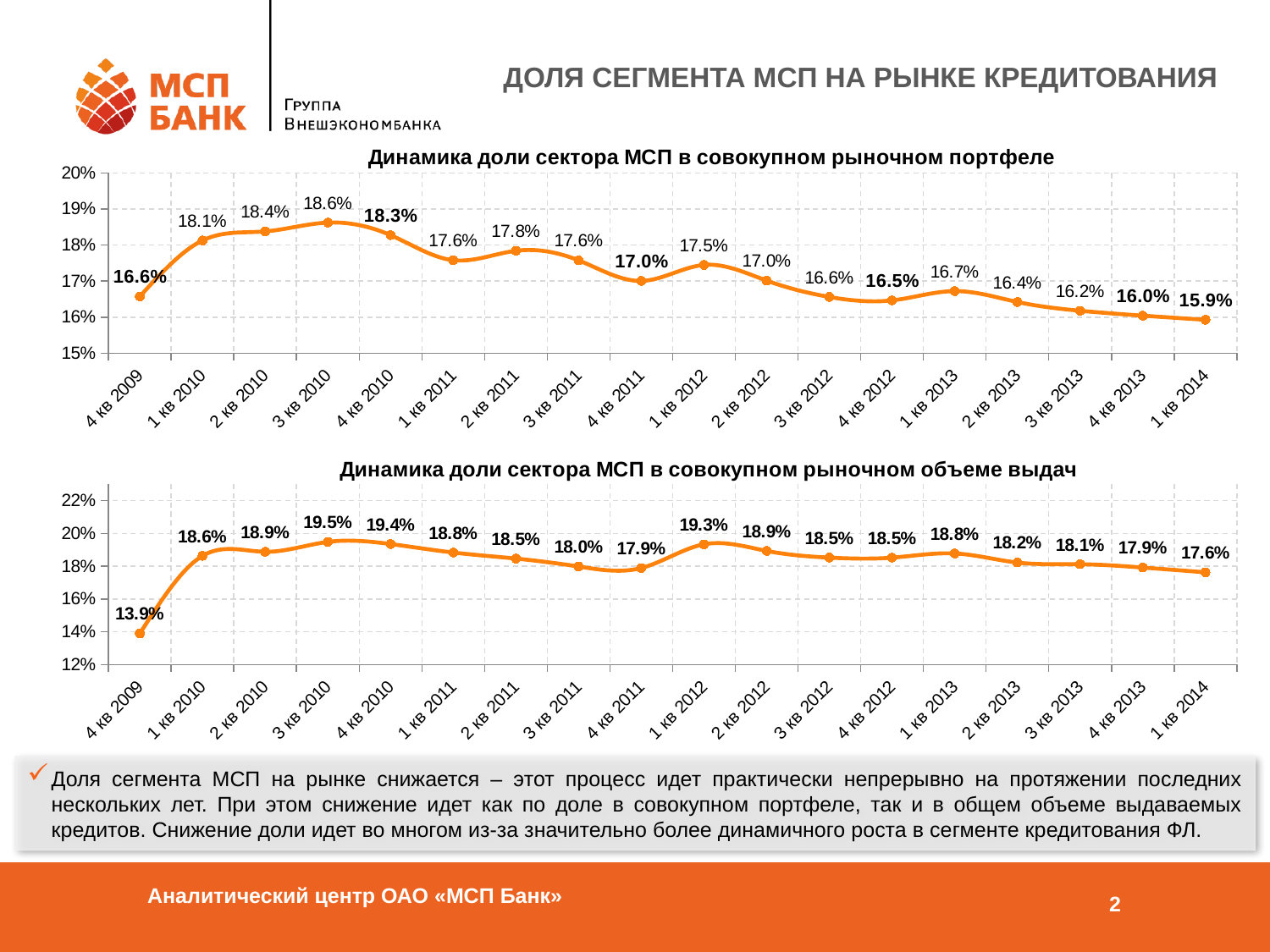
In the top chart (Динамика доли сектора МСП в совокупном рыночном портфеле), how many data points are plotted? 18 In the bottom chart (Динамика доли сектора МСП в совокупном рыночном объеме выдач), which quarter has the highest value? 3 кв 2010 In the bottom chart (Динамика доли сектора МСП в совокупном рыночном объеме выдач), which quarter has the lowest value? 4 кв 2009 In the bottom chart (Динамика доли сектора МСП в совокупном рыночном объеме выдач), what is the difference between the values for 3 кв 2010 and 1 кв 2014? 1.9% In the bottom chart (Динамика доли сектора МСП в совокупном рыночном объеме выдач), which is larger: the value for 1 кв 2012 or the value for 4 кв 2011? 1 кв 2012 In the top chart (Динамика доли сектора МСП в совокупном рыночном портфеле), which quarter has the lowest value? 1 кв 2014 In the bottom chart (Динамика доли сектора МСП в совокупном рыночном объеме выдач), what is the value for 4 кв 2009? 13.9% In the top chart (Динамика доли сектора МСП в совокупном рыночном портфеле), what is the difference between the values for 4 кв 2009 and 1 кв 2010? 1.5% In the top chart (Динамика доли сектора МСП в совокупном рыночном портфеле), which quarter has the highest value? 3 кв 2010 What type of chart is the bottom chart (Динамика доли сектора МСП в совокупном рыночном объеме выдач)? Line chart In the top chart (Динамика доли сектора МСП в совокупном рыночном портфеле), what is the value for 1 кв 2014? 15.9% In the top chart (Динамика доли сектора МСП в совокупном рыночном портфеле), what is the value for 3 кв 2010? 18.6%